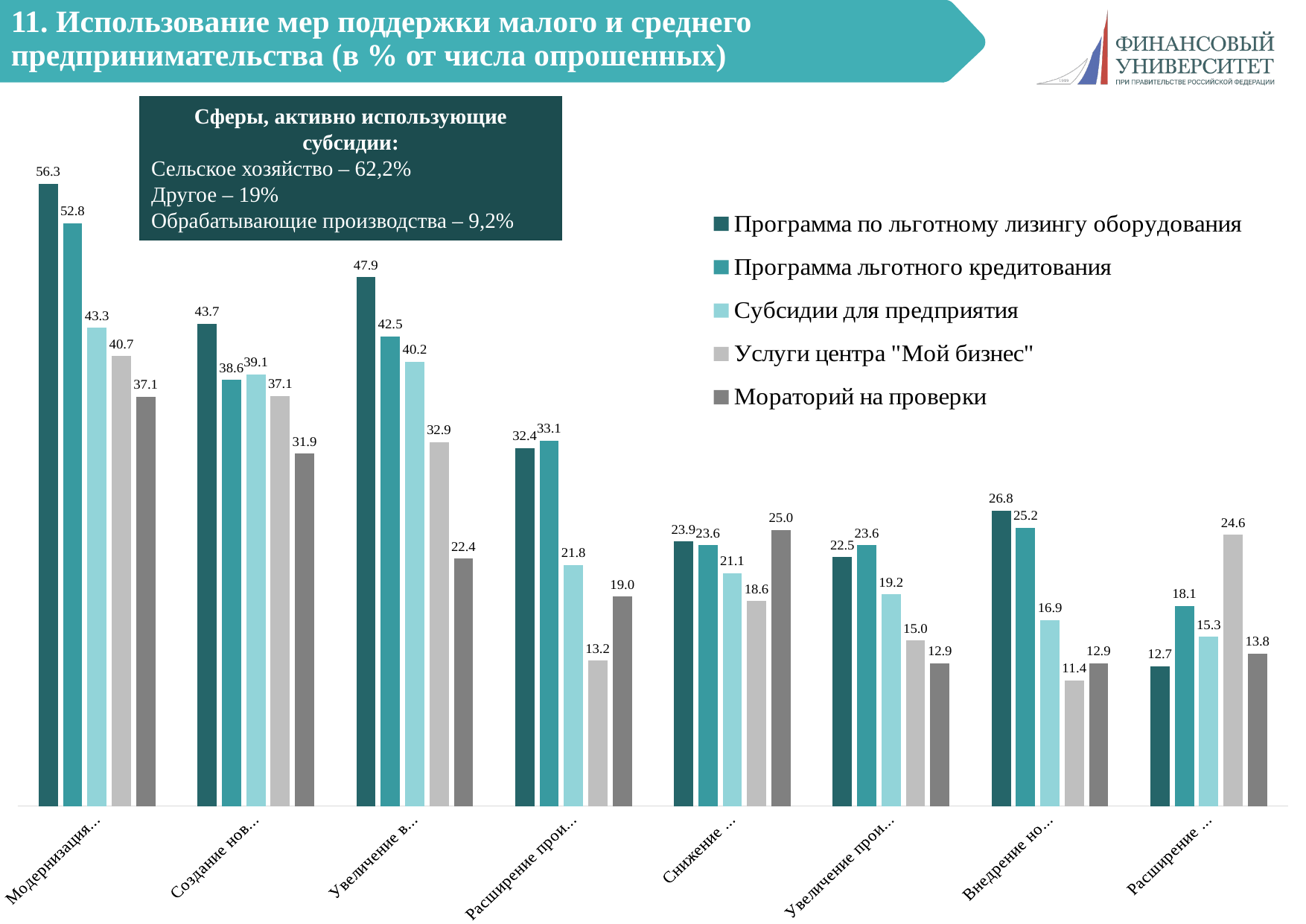
What is the value of "Услуги центра "Мой бизнес"" for the last category ("Расширение ...")? 24.6 What is the value of "Мораторий на проверки" for the category "Снижение ..." (fifth group)? 25.0 For which category is the value of "Программа по льготному лизингу оборудования" the highest? Модернизация... (first category) For which category is the value of "Услуги центра "Мой бизнес"" the lowest? Внедрение но... (seventh category) According to the text box on the slide, what share of agriculture (Сельское хозяйство) actively uses subsidies? 62,2% How many series does the chart legend list? 5 What is the value of "Программа по льготному лизингу оборудования" for the first category ("Модернизация...")? 56.3 In the last category ("Расширение ..."), which is larger: "Услуги центра "Мой бизнес"" or "Мораторий на проверки"? Услуги центра "Мой бизнес" What kind of chart is shown on the slide? bar chart What is the value of "Субсидии для предприятия" for the category "Увеличение в..." (third group)? 40.2 How many categories (groups of bars) are plotted along the x axis? 8 In the first category ("Модернизация..."), what is the difference between "Программа по льготному лизингу оборудования" and "Программа льготного кредитования"? 3.5